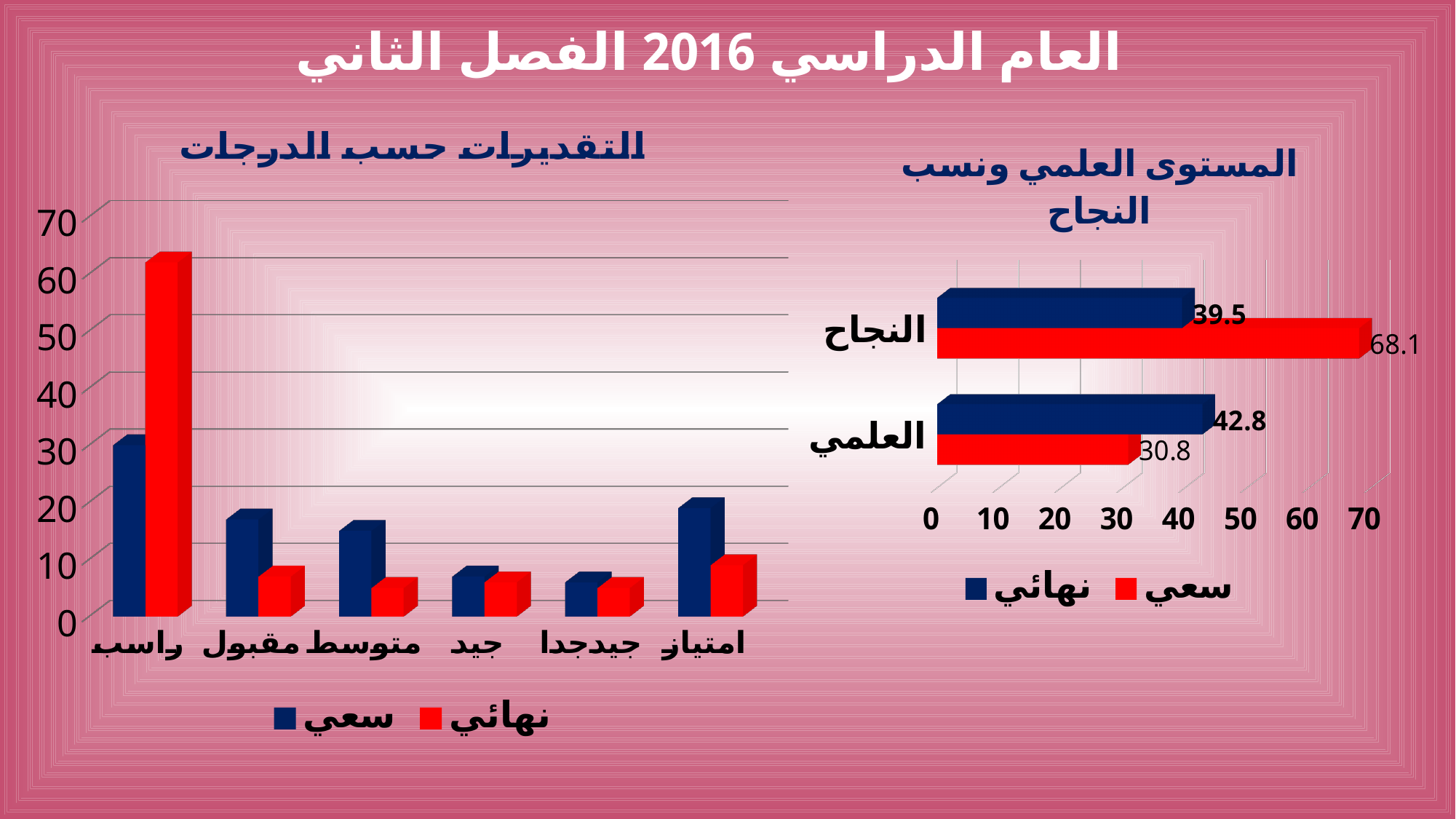
What kind of chart is the chart titled التقديرات حسب الدرجات? bar chart In the chart titled التقديرات حسب الدرجات, is the نهائي value for راسب greater or less than 50? greater In the chart titled المستوى العلمي ونسب النجاح, what is the difference between the نهائي and سعي values for العلمي? 12 In the chart titled المستوى العلمي ونسب النجاح, what is the سعي value for النجاح? 68.1 In the chart titled المستوى العلمي ونسب النجاح, which bar has the highest value? سعي for النجاح (68.1) In the chart titled المستوى العلمي ونسب النجاح, what is the نهائي value for العلمي? 42.8 In the chart titled التقديرات حسب الدرجات, which category has the highest نهائي value? راسب In the chart titled المستوى العلمي ونسب النجاح, what is the نهائي value for النجاح? 39.5 In the chart titled المستوى العلمي ونسب النجاح, what is the سعي value for العلمي? 30.8 In the chart titled المستوى العلمي ونسب النجاح, what is the difference between the سعي and نهائي values for النجاح? 28.6 How many categories are shown on the x axis of the chart titled التقديرات حسب الدرجات? 6 In the chart titled المستوى العلمي ونسب النجاح, which series has the larger value for العلمي, نهائي or سعي? نهائي